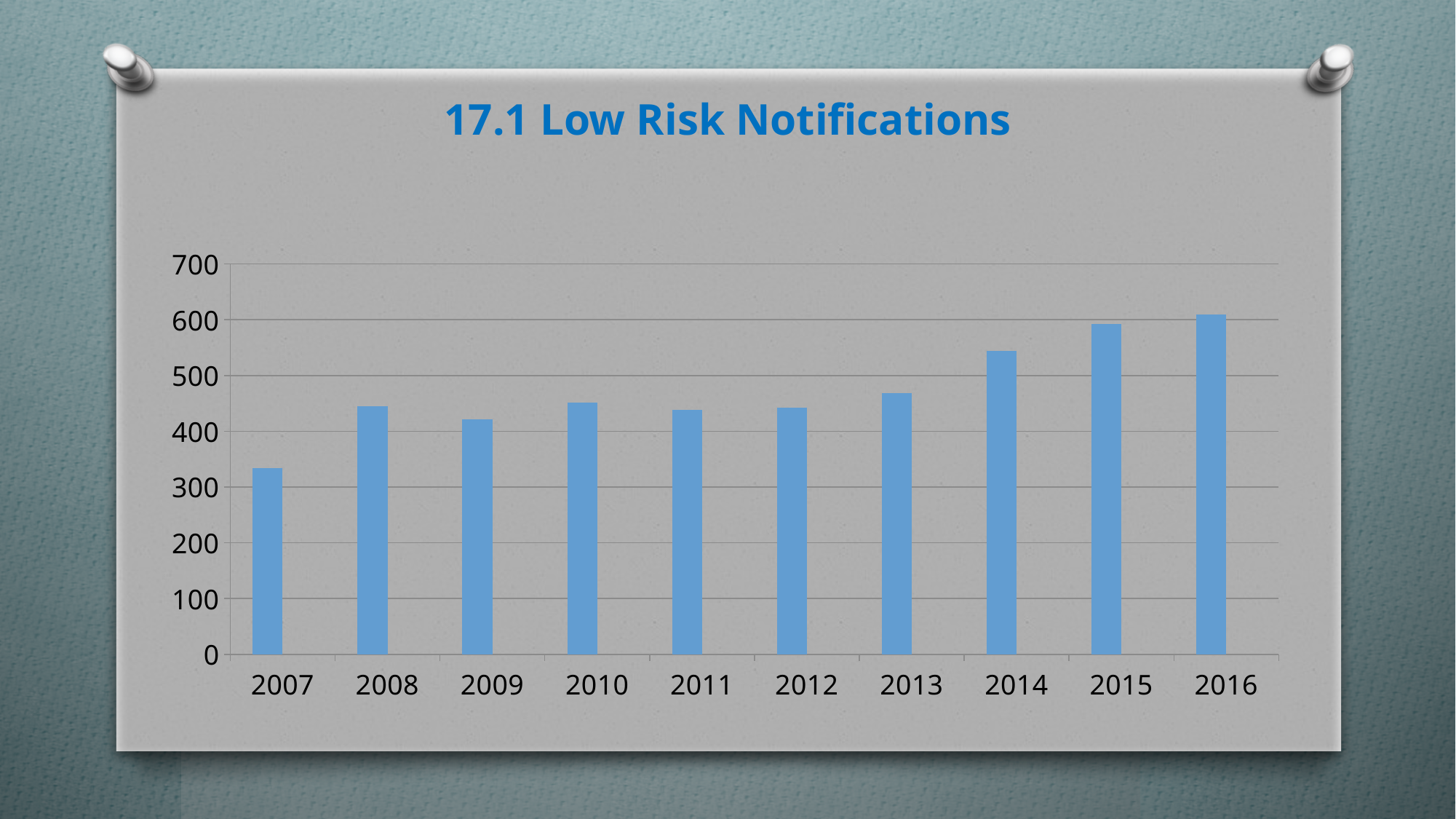
Which year has the lowest number of low risk notifications? 2007 How many years are shown on the x axis of the chart? 10 What kind of chart is shown on the slide? bar chart Is the value for 2014 greater or less than 500? greater Which year has the larger value, 2009 or 2014? 2014 Which year has the highest number of low risk notifications? 2016 Is the value for 2009 greater or less than 500? less Which year has the larger value, 2007 or 2013? 2013 Is the value for 2007 greater or less than 400? less What is the title of the chart? 17.1 Low Risk Notifications Do the values generally rise or fall from 2007 to 2016? rise